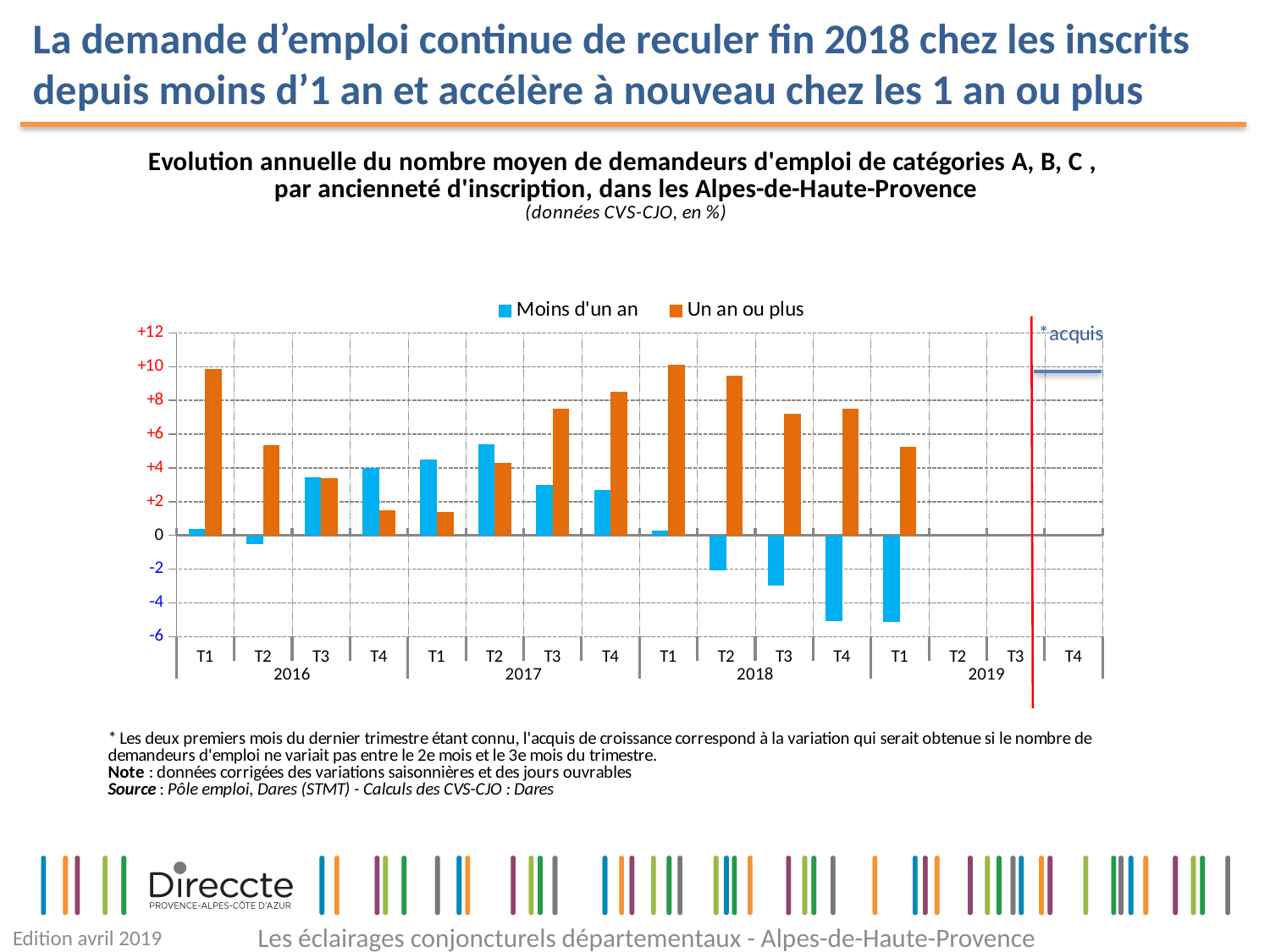
What are the two series named in the legend? Moins d'un an and Un an ou plus What kind of chart is shown on the slide? bar chart Is the value for Un an ou plus in T1 2016 greater or less than +8? greater How many quarters have bars plotted in the chart? 13 In which quarter does the Moins d'un an series reach its highest value? T2 2017 In T2 2018, which series has the larger value, Moins d'un an or Un an ou plus? Un an ou plus Is the value for Moins d'un an in T2 2017 greater or less than +4? greater Is the value for Moins d'un an in T4 2018 greater or less than -4? less In T4 2016, which series has the larger value, Moins d'un an or Un an ou plus? Moins d'un an How many series does the legend list? 2 Do the values for Moins d'un an rise or fall from T1 2018 to T4 2018? fall